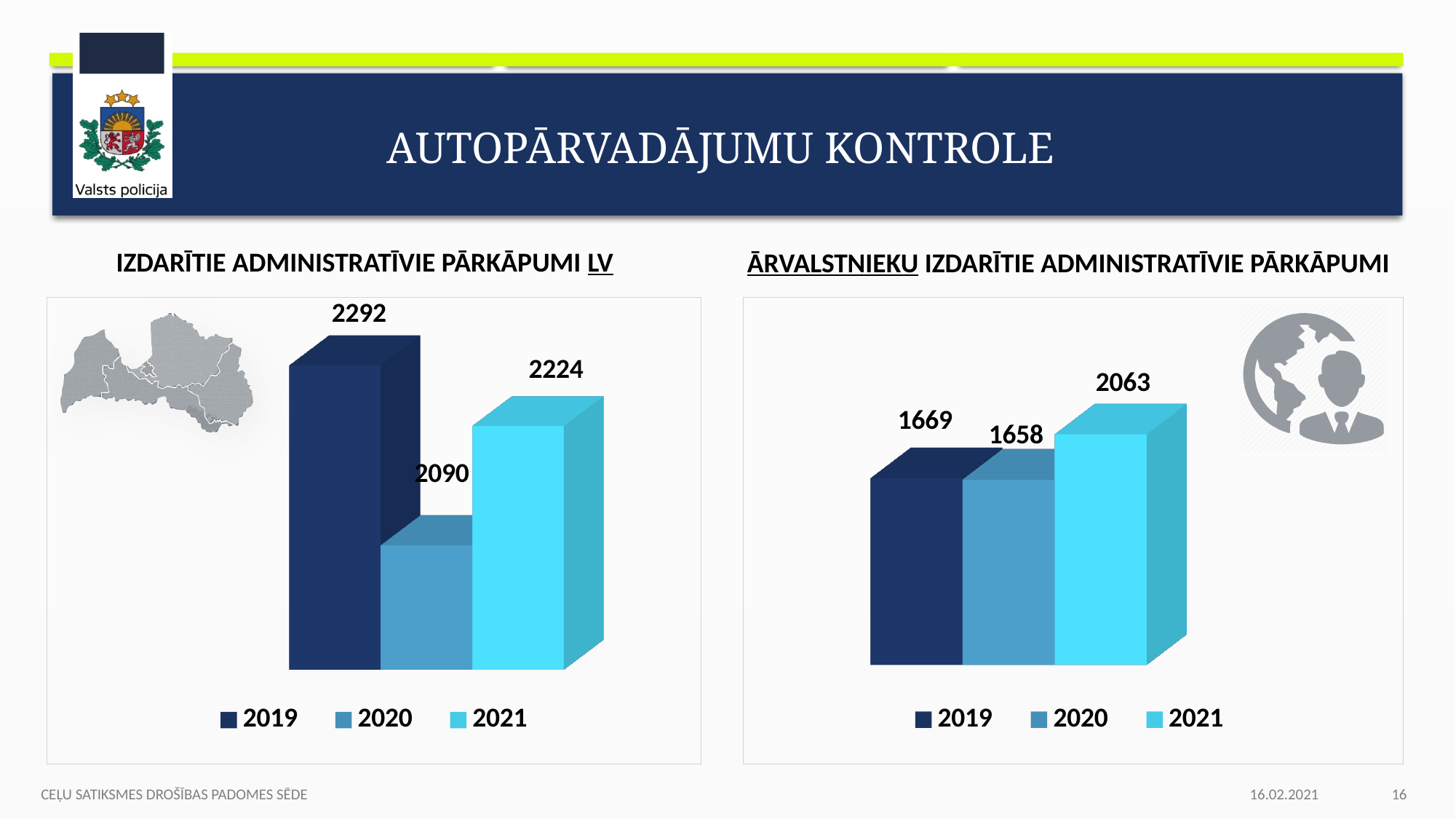
In the right chart (ĀRVALSTNIEKU IZDARĪTIE ADMINISTRATĪVIE PĀRKĀPUMI), which year has the highest value? 2021 In the chart titled "IZDARĪTIE ADMINISTRATĪVIE PĀRKĀPUMI LV", what is the value for 2020? 2090 In the left chart (IZDARĪTIE ADMINISTRATĪVIE PĀRKĀPUMI LV), which year has the highest value? 2019 What kind of chart is the right chart (ĀRVALSTNIEKU IZDARĪTIE ADMINISTRATĪVIE PĀRKĀPUMI)? Bar chart In the left chart (IZDARĪTIE ADMINISTRATĪVIE PĀRKĀPUMI LV), what is the difference between the 2019 and 2020 values? 202 How many series does the legend of the left chart (IZDARĪTIE ADMINISTRATĪVIE PĀRKĀPUMI LV) list? 3 In the left chart (IZDARĪTIE ADMINISTRATĪVIE PĀRKĀPUMI LV), which year has the lowest value? 2020 In the chart titled "ĀRVALSTNIEKU IZDARĪTIE ADMINISTRATĪVIE PĀRKĀPUMI", what is the value for 2019? 1669 In the right chart (ĀRVALSTNIEKU IZDARĪTIE ADMINISTRATĪVIE PĀRKĀPUMI), what is the difference between the 2021 and 2020 values? 405 In the right chart (ĀRVALSTNIEKU IZDARĪTIE ADMINISTRATĪVIE PĀRKĀPUMI), which is larger, the value for 2019 or the value for 2020? 2019 In the chart titled "ĀRVALSTNIEKU IZDARĪTIE ADMINISTRATĪVIE PĀRKĀPUMI", what is the value for 2021? 2063 In the chart titled "IZDARĪTIE ADMINISTRATĪVIE PĀRKĀPUMI LV", what is the value for 2019? 2292